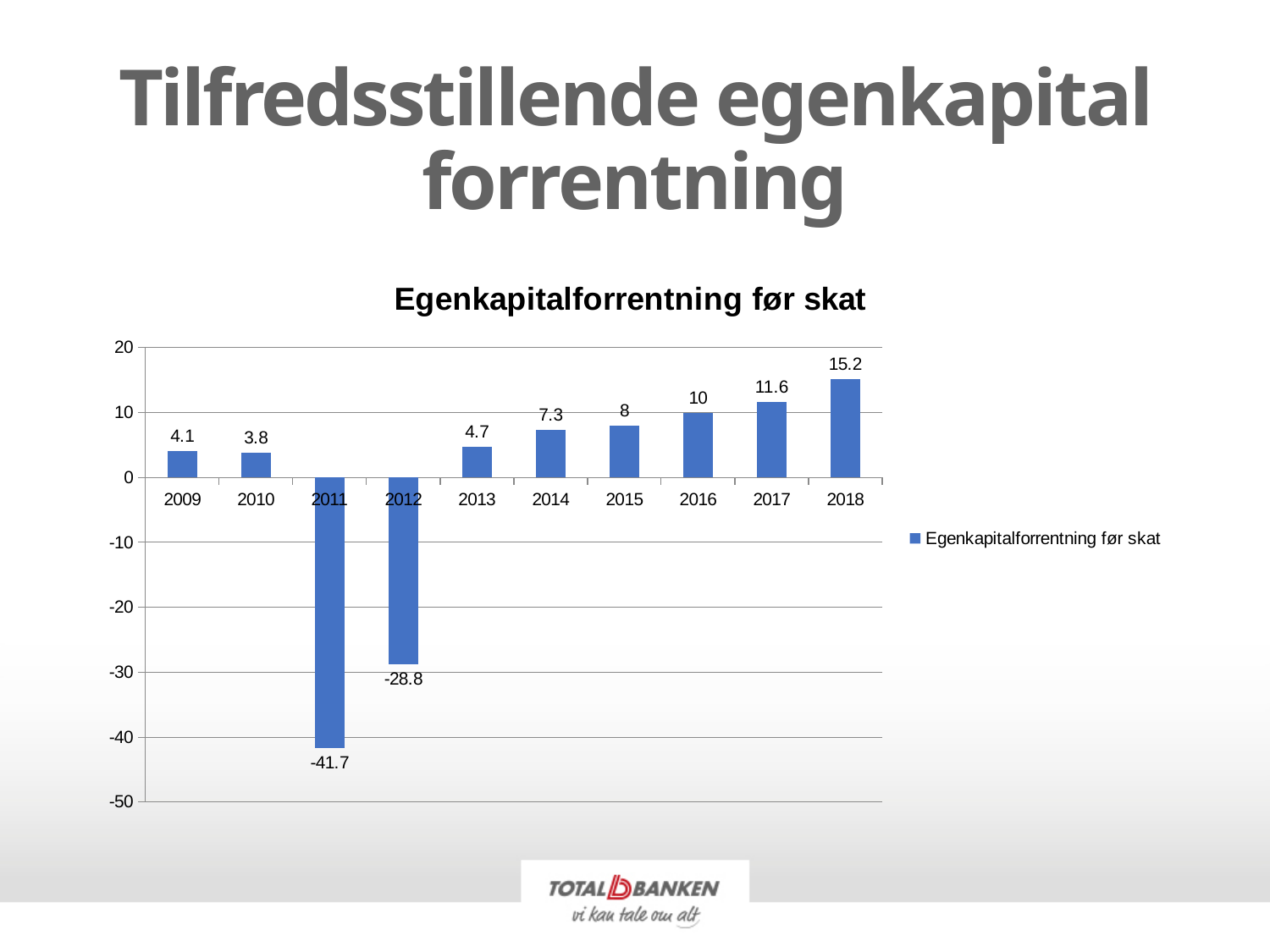
What is the value for 2011? -41.7 How many years are shown on the x axis? 10 Do the values rise or fall from 2013 to 2018? rise Which is larger, the value for 2009 or the value for 2010? 2009 What is the value for 2014? 7.3 What kind of chart is shown? bar chart Which year has the highest value? 2018 How many series does the legend list? 1 What is the value for 2018? 15.2 Which year has the lowest value? 2011 What is the difference between the values for 2018 and 2017? 3.6 What is the difference between the values for 2012 and 2011? 12.9